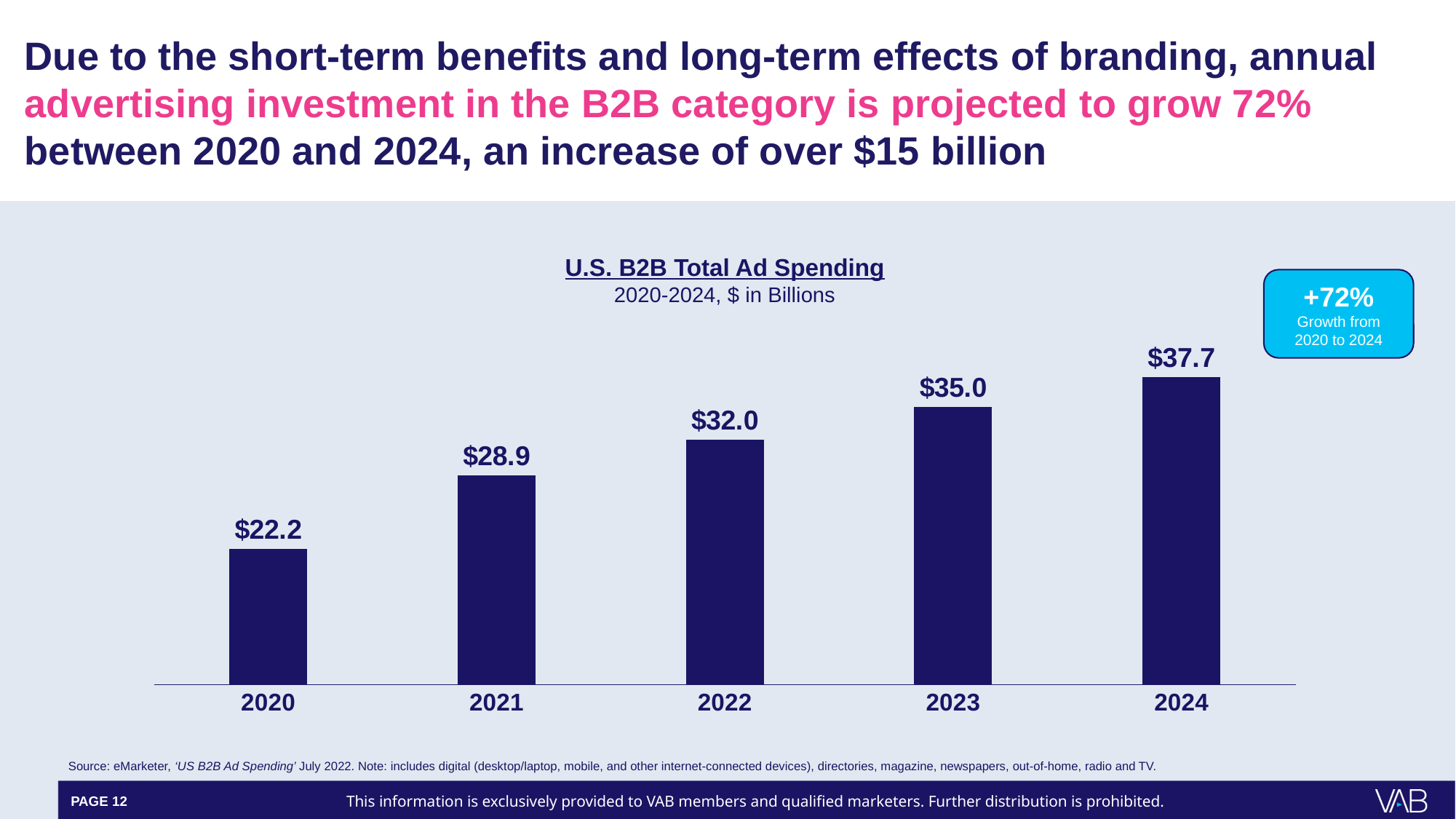
What is the difference between the values for 2023 and 2021? $6.1 What is the difference between the values for 2024 and 2020? $15.5 Which year has the lowest value? 2020 What is the value for 2022? $32.0 Which year has the highest value? 2024 How many years are shown on the chart? 5 Which is larger, the value for 2021 or the value for 2023? 2023 Do the values rise or fall from 2020 to 2024? rise What is the value for 2020? $22.2 What is the title of the chart? U.S. B2B Total Ad Spending What kind of chart is this? bar chart What is the value for 2024? $37.7